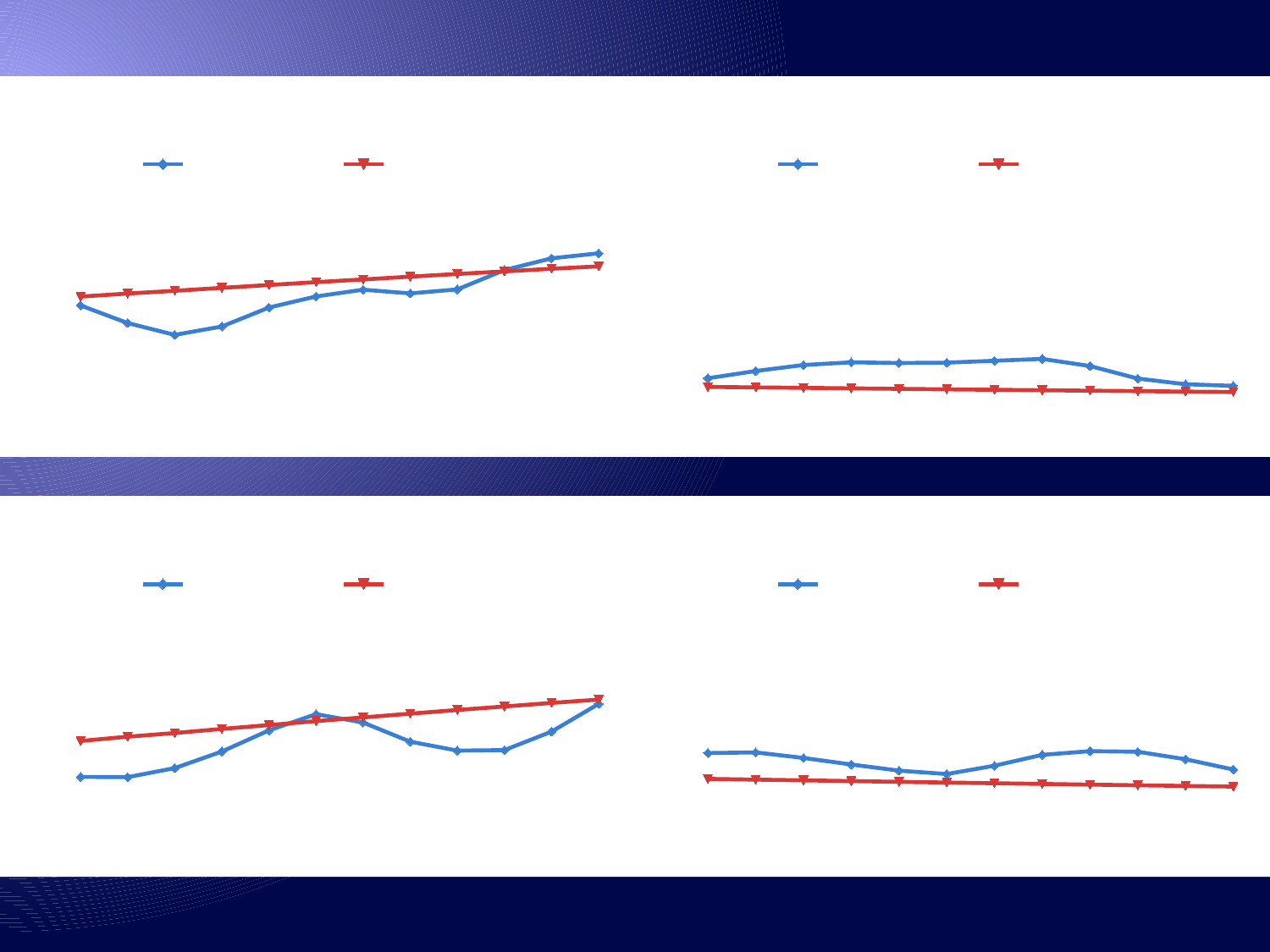
How many data points does the blue line in the top-left chart have? 12 How many data points does the red line in the bottom-right chart have? 12 In the bottom-right chart, does the red line rise or fall from left to right? Fall How many series does the legend of the top-right chart list? 2 In the bottom-left chart, does the red line rise or fall from left to right? Rise In the top-right chart, which line is higher at every point, the blue line or the red line? The blue line How many charts are shown on the slide? 4 In the bottom-right chart, which line is higher at every point, the blue line or the red line? The blue line In the top-left chart, which line is higher at the first point on the left, the blue line or the red line? The red line In the top-left chart, does the red line rise or fall from left to right? Rise What kind of chart is the top-left chart on the slide? Line chart